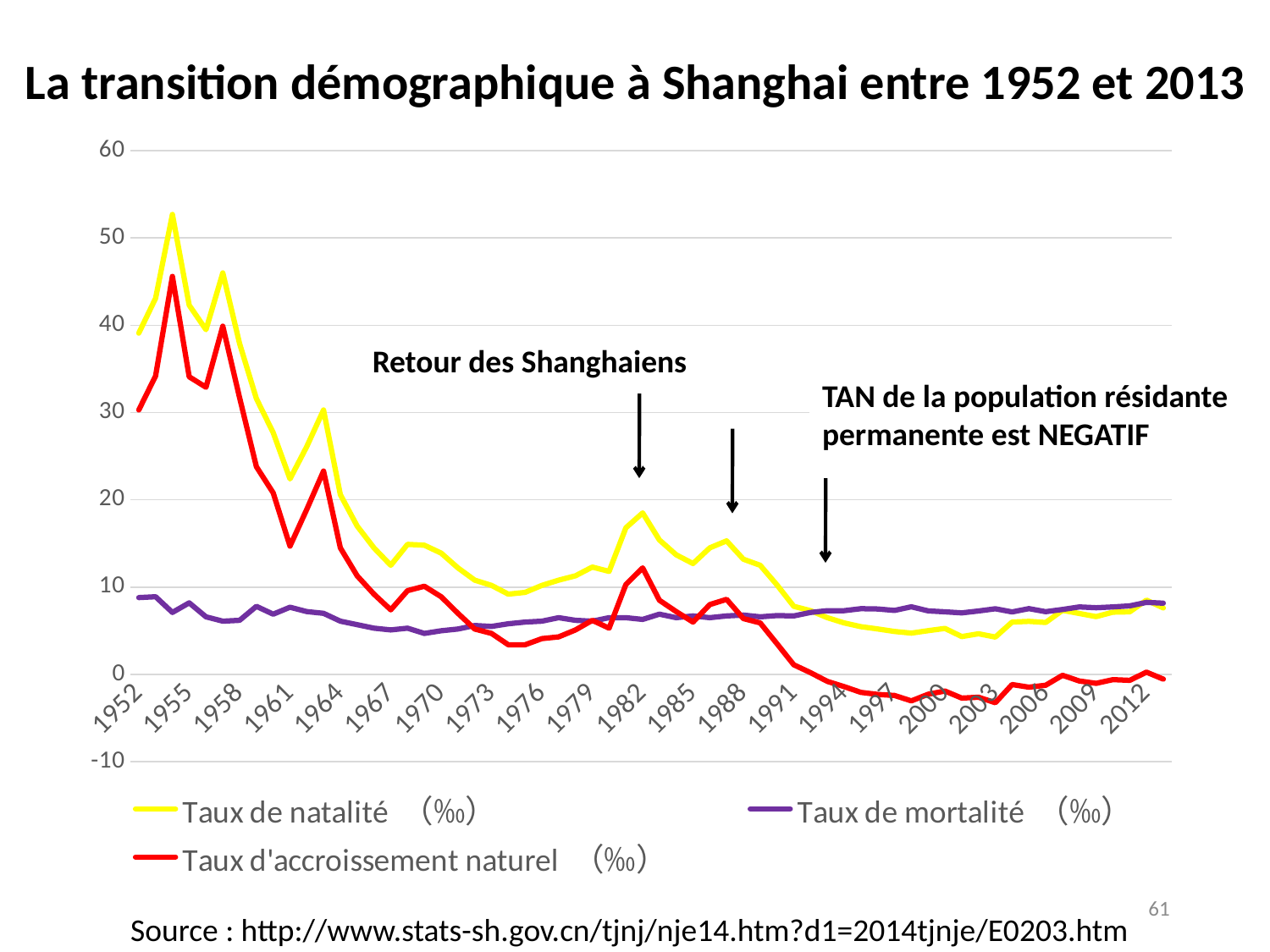
Is the value of Taux d'accroissement naturel in 2000 greater or less than 0? less Which series is drawn in purple? Taux de mortalité (‰) Is the value of Taux de natalité in 1982 greater or less than 20? less Is the value of Taux d'accroissement naturel in 1954 greater or less than 40? greater How many series does the legend list? 3 In 2000, which is larger: Taux de mortalité or Taux d'accroissement naturel? Taux de mortalité What kind of chart is shown on the slide? line chart Does Taux de natalité rise or fall between 1954 and 1973? fall What is the title of the chart? La transition démographique à Shanghai entre 1952 et 2013 Which series has the highest value in 1954? Taux de natalité (‰)